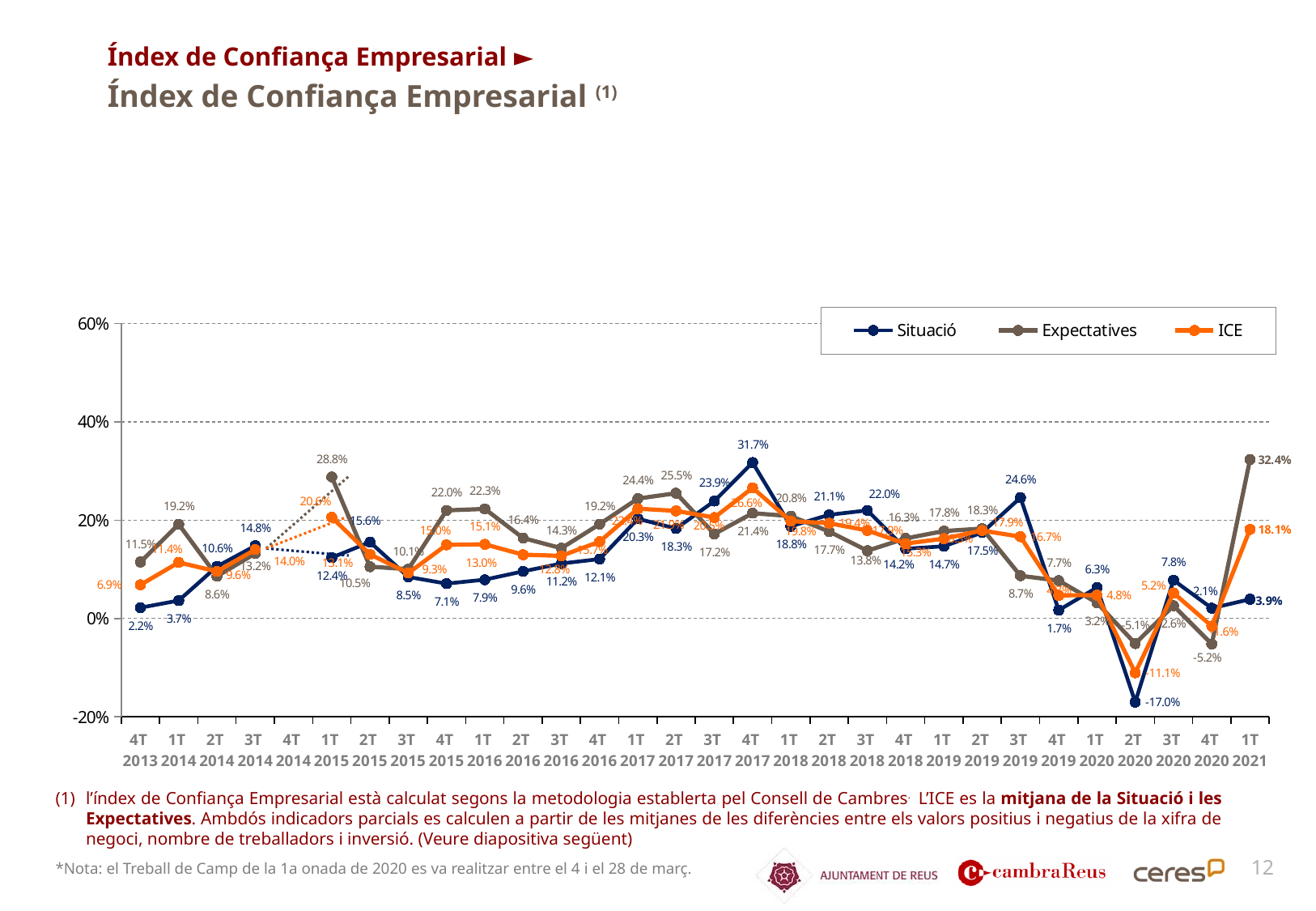
What is the value of Expectatives in 1T 2021? 32.4% What is the value of ICE in 1T 2021? 18.1% Which series is shown in orange in the legend? ICE What is the difference between Expectatives and Situació in 1T 2021? 28.5% In which quarter does the Situació series reach its lowest value? 2T 2020 How many series does the legend list? 3 What is the value of Situació in 4T 2017? 31.7% In which quarter does the ICE series reach its highest value? 4T 2017 What is the value of ICE in 2T 2020? -11.1% Which is larger in 3T 2019, Situació or Expectatives? Situació Is the value of Expectatives in 1T 2015 greater or less than 20%? greater What type of chart is shown on the slide? line chart